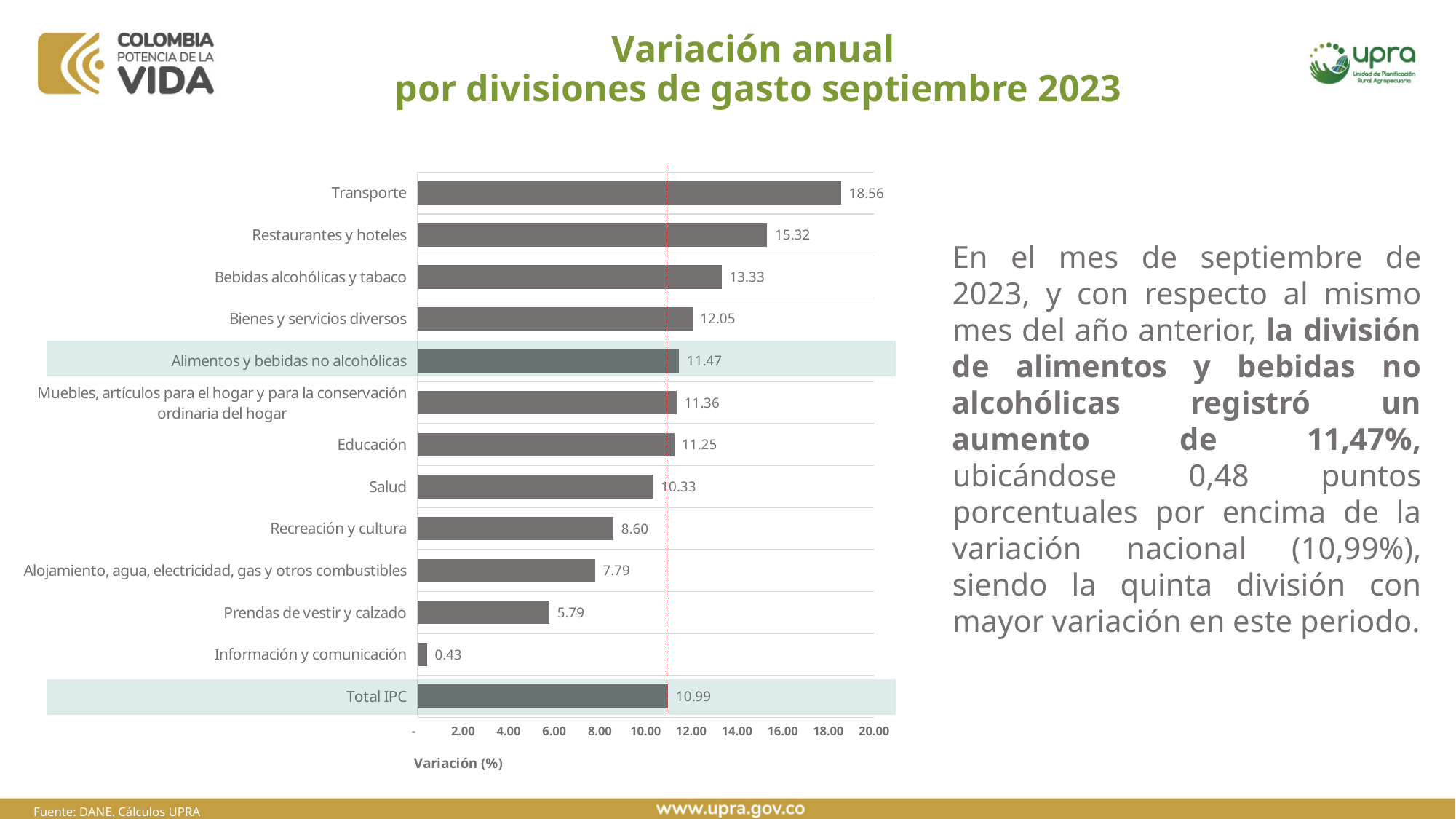
What is the value for Total IPC? 10.99 Is the value for Recreación y cultura greater or less than 10.00? less What is the value for Transporte? 18.56 Which has a larger value, Educación or Salud? Educación What kind of chart is shown on the slide? bar chart Which category has the highest value? Transporte What is the value for Prendas de vestir y calzado? 5.79 What is the difference between the values for Transporte and Total IPC? 7.57 What is the difference between the values for Alimentos y bebidas no alcohólicas and Total IPC? 0.48 How many bars are shown in the chart? 13 What is the value for Alimentos y bebidas no alcohólicas? 11.47 Which category has the lowest value? Información y comunicación